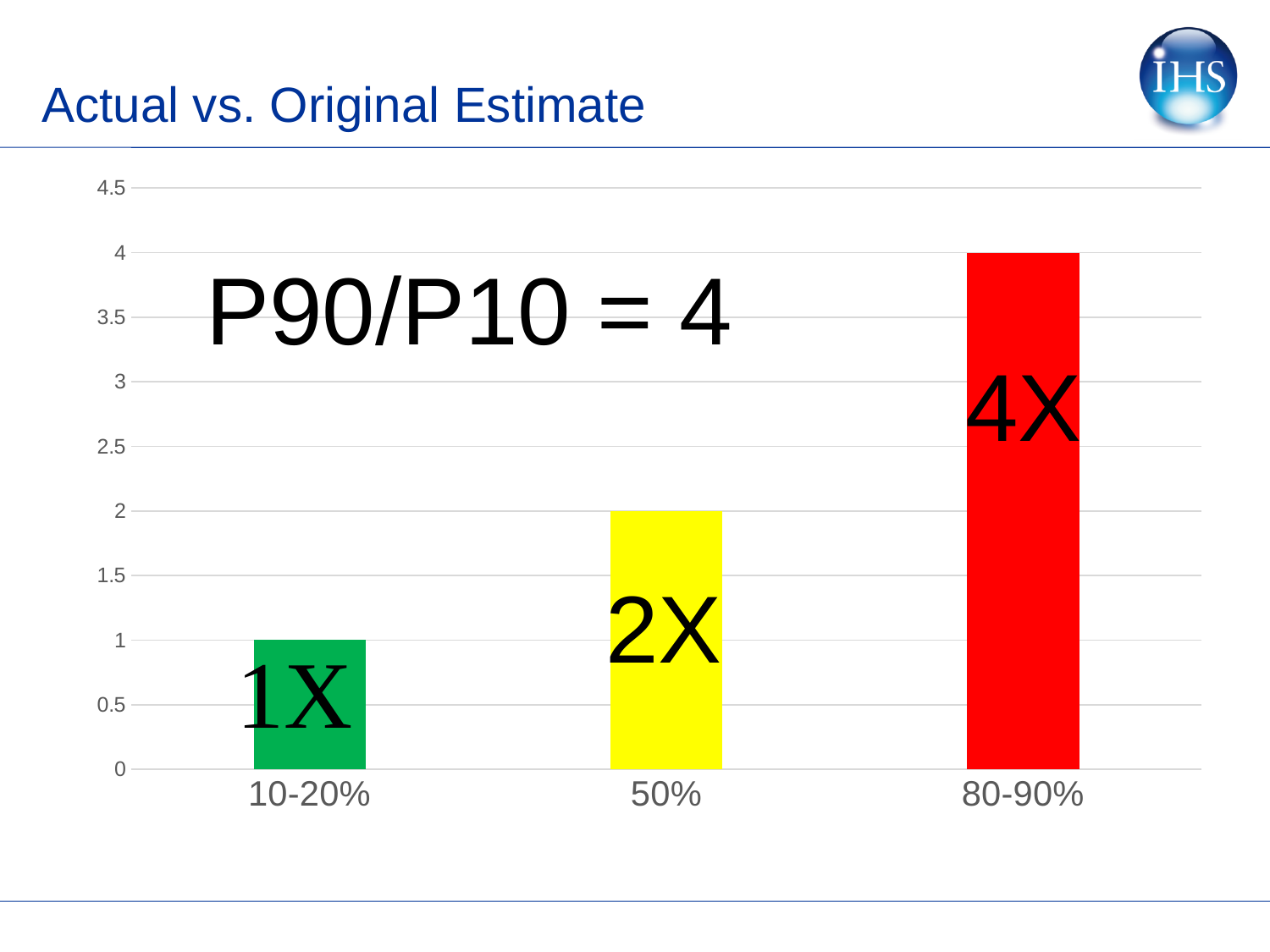
What label is printed on the bar for the 50% category? 2X What is the title of the slide containing the chart? Actual vs. Original Estimate Which bar is taller, the one for 50% or the one for 10-20%? 50% How many bars (categories) does the chart show? 3 Which category has the highest bar? 80-90% What kind of chart is shown on the slide? bar chart Do the bar values rise or fall from left to right across the categories? rise What label is printed on the bar for the 80-90% category? 4X Which category has the lowest bar? 10-20% What colour is the bar for the 80-90% category? red Is the value for 80-90% greater or less than 3? greater What label is printed on the bar for the 10-20% category? 1X